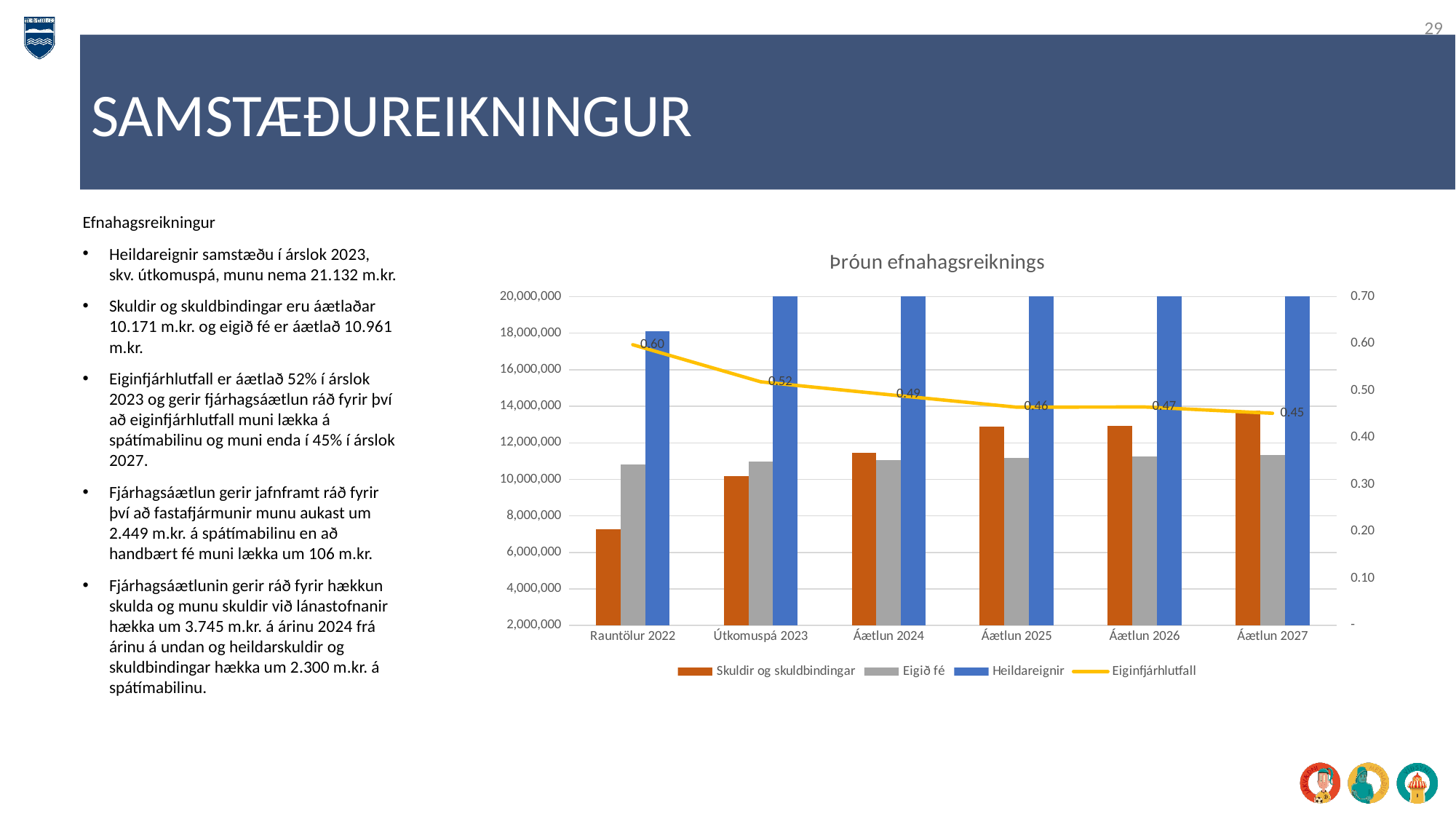
Is the Skuldir og skuldbindingar value for Rauntölur 2022 greater or less than 8,000,000? less Which is larger, the Eiginfjárhlutfall value for Áætlun 2025 or for Áætlun 2026? Áætlun 2026 Is the Skuldir og skuldbindingar value for Áætlun 2027 greater or less than 12,000,000? greater What is the difference between the Eiginfjárhlutfall values for Rauntölur 2022 and Áætlun 2027? 0.15 What is the Eiginfjárhlutfall value for Útkomuspá 2023? 0.52 How many categories are shown on the x axis of the chart? 6 What is the Eiginfjárhlutfall value for Rauntölur 2022? 0.60 Which category has the lowest Eiginfjárhlutfall value? Áætlun 2027 Does the Eiginfjárhlutfall line generally rise or fall from Rauntölur 2022 to Áætlun 2027? fall How many series does the chart legend list? 4 Which category has the highest Eiginfjárhlutfall value? Rauntölur 2022 What is the Eiginfjárhlutfall value for Áætlun 2027? 0.45